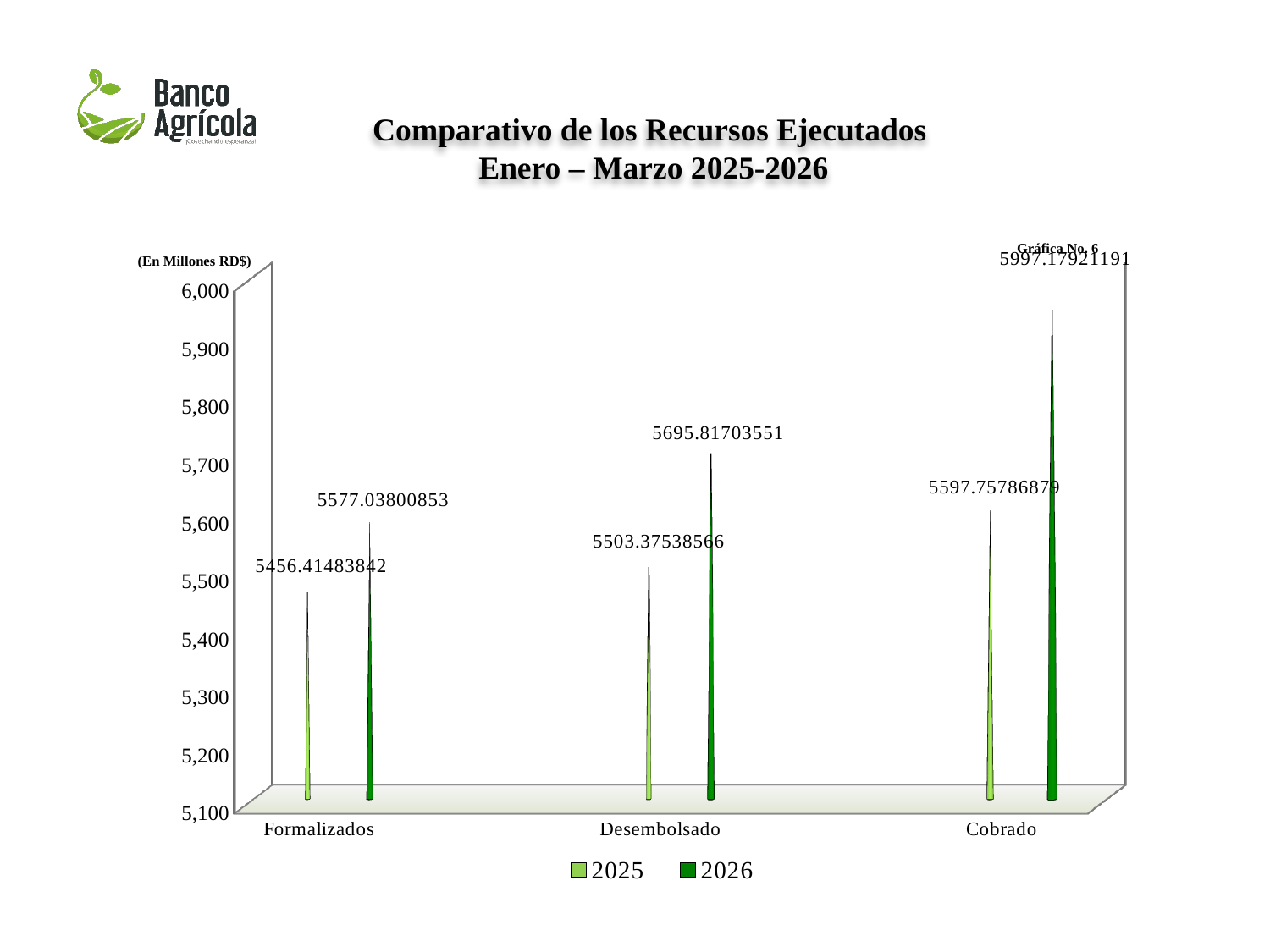
What is the value for Formalizados in the 2025 series? 5456.41483842 How many categories are shown on the x axis? 3 Which is larger for Desembolsado, the 2025 value or the 2026 value? 2026 What is the value for Cobrado in the 2025 series? 5597.75786879 What is the value for Cobrado in the 2026 series? 5997.17921191 Which category has the highest value in the 2026 series? Cobrado What is the title of the chart? Comparativo de los Recursos Ejecutados Enero – Marzo 2025-2026 Which category has the lowest value in the 2025 series? Formalizados What is the value for Desembolsado in the 2026 series? 5695.81703551 What is the difference between the 2026 and 2025 values for Cobrado? 399.42134312 How many series does the legend list? 2 What is the difference between the 2026 and 2025 values for Formalizados? 120.62317011